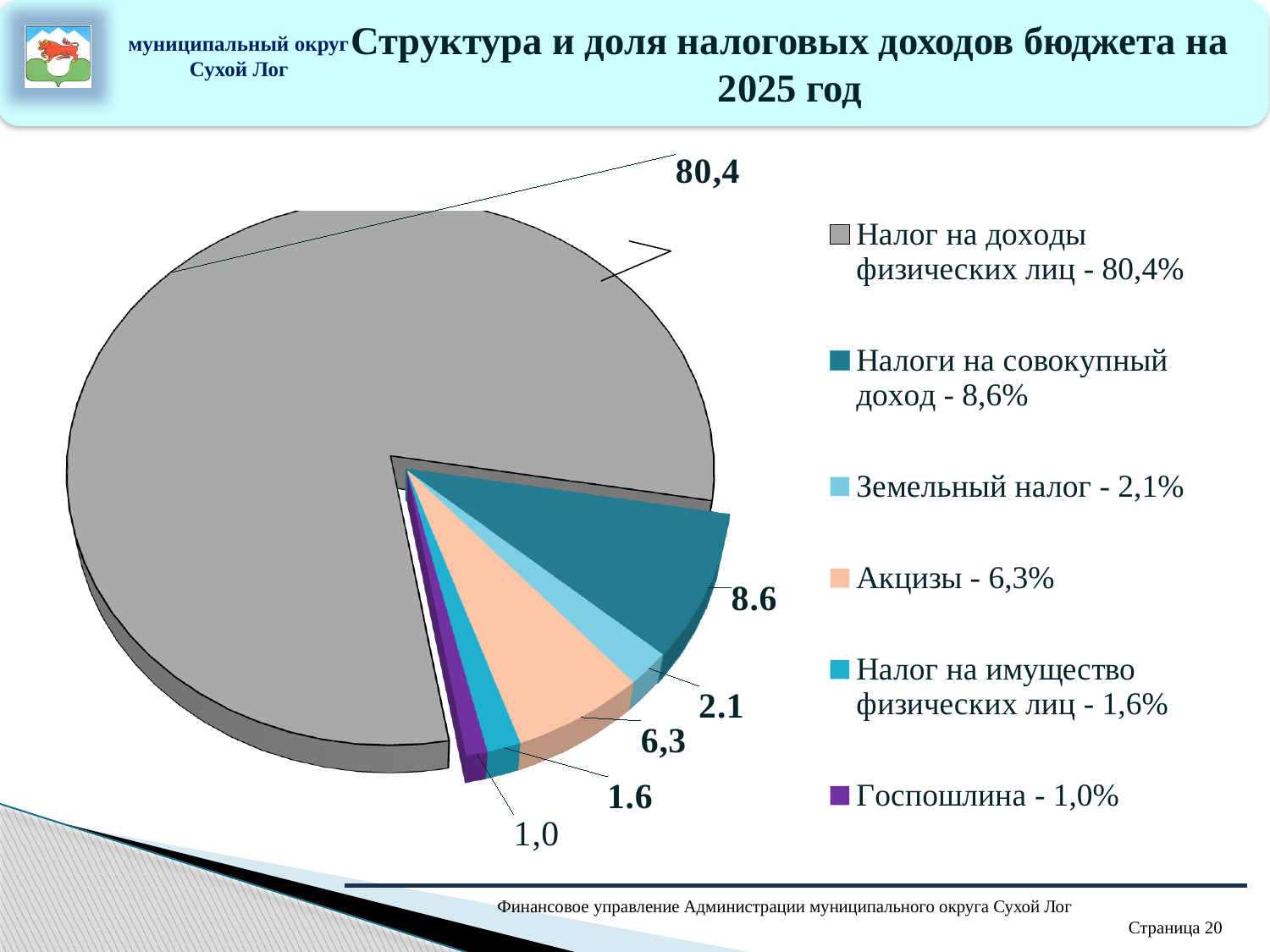
What kind of chart is shown on the slide? pie chart According to the legend, what share is Земельный налог? 2,1% According to the legend, what share is Акцизы? 6,3% How many entries does the legend list? 6 Which category has the largest slice of the pie? Налог на доходы физических лиц According to the legend, what share is Госпошлина? 1,0% What is the difference in percentage points between Налоги на совокупный доход (8,6%) and Налог на имущество физических лиц (1,6%)? 7,0 How many slices does the pie chart have? 6 Which category has the smallest slice of the pie? Госпошлина Which is larger, the share of Акцизы or the share of Земельный налог? Акцизы